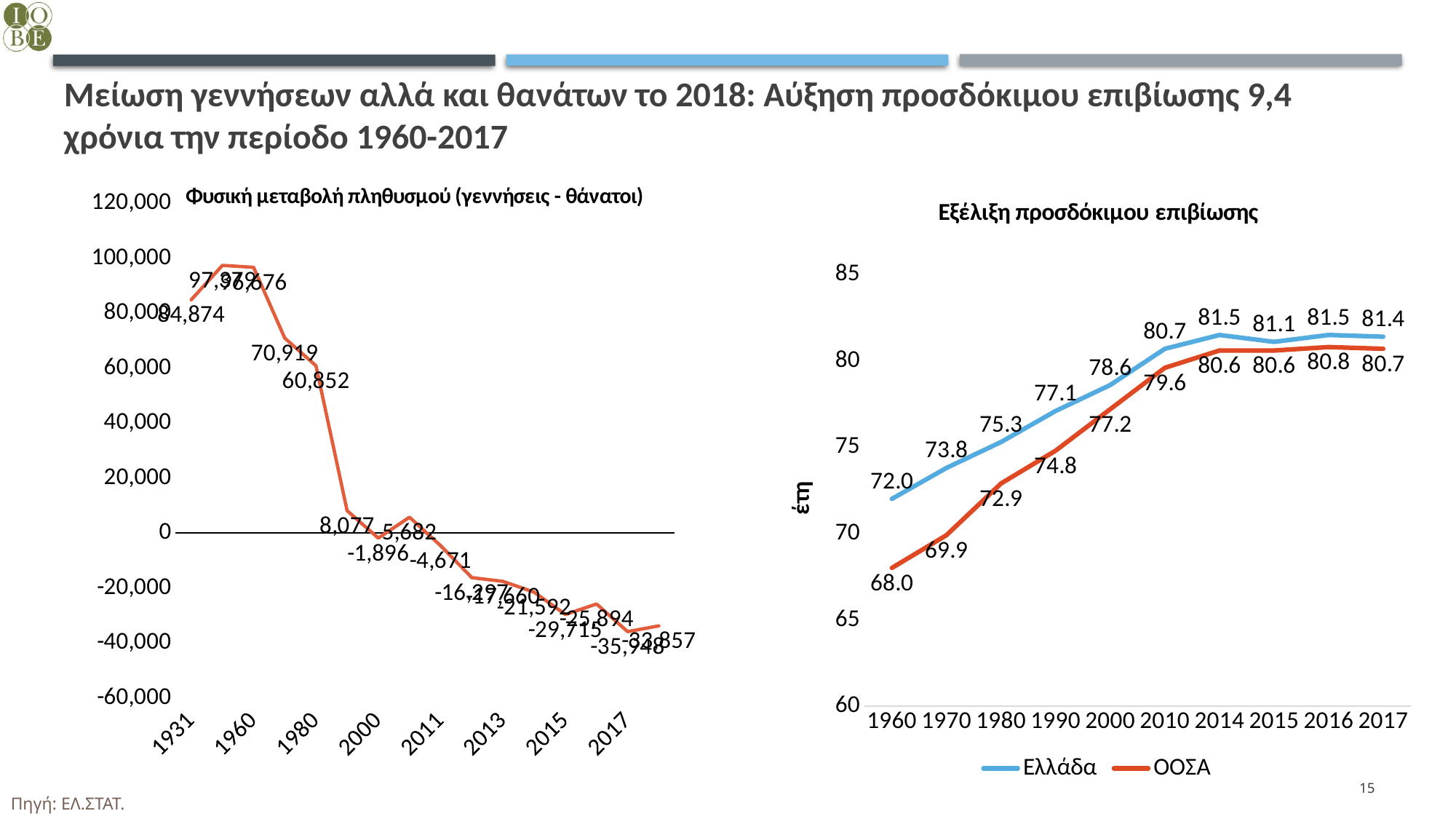
In the left chart 'Φυσική μεταβολή πληθυσμού', what is the value for 2017? -35,948 In the left chart 'Φυσική μεταβολή πληθυσμού', do the values generally rise or fall from 1931 to 2017? Fall In the left chart 'Φυσική μεταβολή πληθυσμού', what is the value for 1931? 84,874 In the right chart 'Εξέλιξη προσδόκιμου επιβίωσης', which series has the higher value in 2000, Ελλάδα or ΟΟΣΑ? Ελλάδα In the right chart 'Εξέλιξη προσδόκιμου επιβίωσης', how many years are shown on the x axis? 10 In the right chart 'Εξέλιξη προσδόκιμου επιβίωσης', what is the difference between Ελλάδα and ΟΟΣΑ in 1960? 4.0 What type of chart is the left chart, 'Φυσική μεταβολή πληθυσμού (γεννήσεις - θάνατοι)'? Line chart In the right chart 'Εξέλιξη προσδόκιμου επιβίωσης', what is the value for Ελλάδα in 1960? 72.0 In the left chart 'Φυσική μεταβολή πληθυσμού', what is the value for 1980? 60,852 In the left chart 'Φυσική μεταβολή πληθυσμού', is the value for 1960 greater or less than 80,000? greater In the right chart 'Εξέλιξη προσδόκιμου επιβίωσης', what is the value for ΟΟΣΑ in 2017? 80.7 In the right chart 'Εξέλιξη προσδόκιμου επιβίωσης', how many series does the legend list? 2